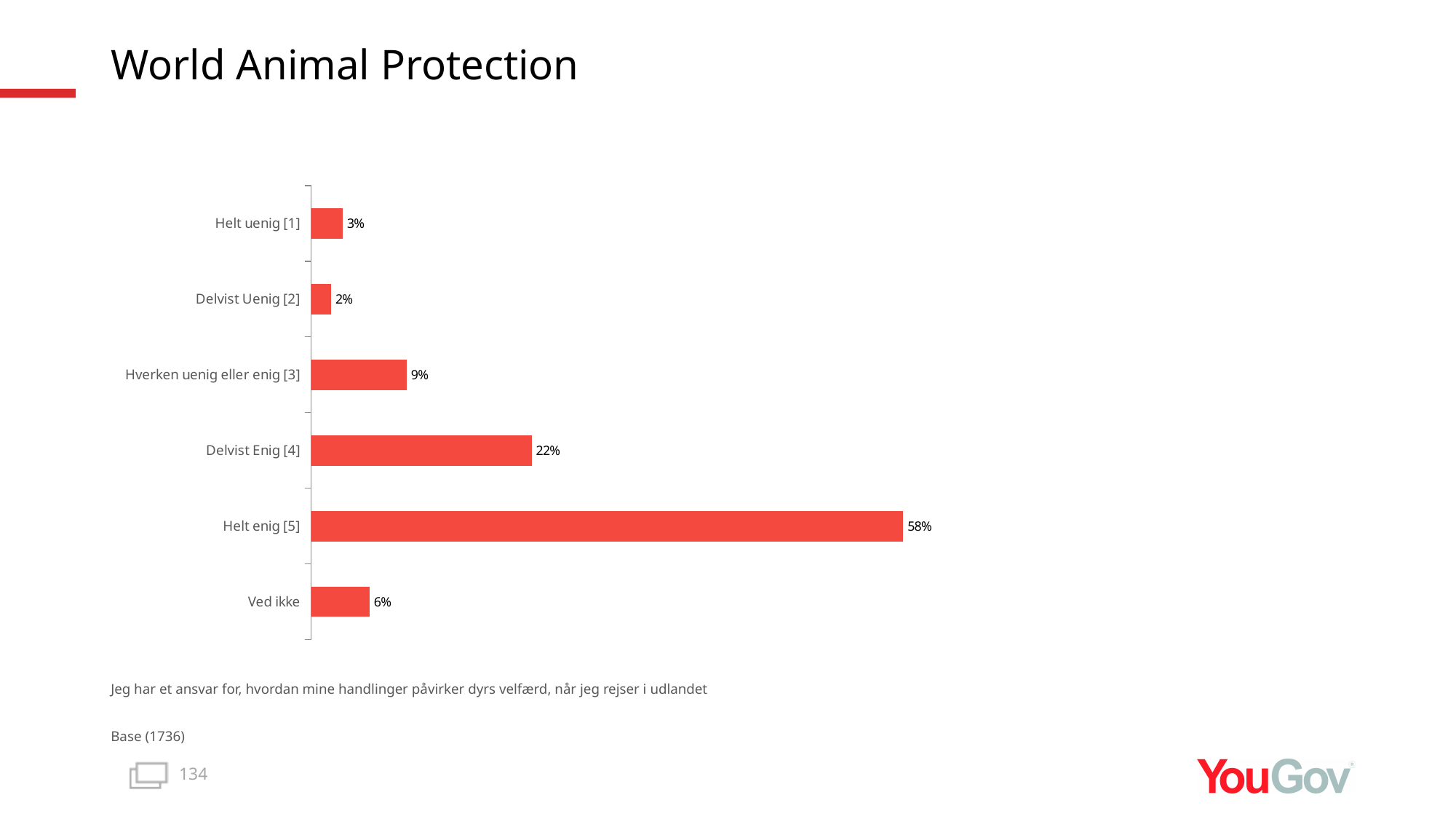
Which response category has the highest value? Helt enig [5] Which is larger, "Helt uenig [1]" or "Ved ikke"? Ved ikke Which response category has the lowest value? Delvist Uenig [2] What is the combined percentage of "Helt uenig [1]" and "Delvist Uenig [2]"? 5% What type of chart is shown on the slide? Bar chart What is the base (number of respondents) stated below the chart? 1736 How many response categories are shown in the chart? 6 What is the value shown for "Delvist Enig [4]"? 22% What percentage is shown for "Ved ikke"? 6% What is the value for "Hverken uenig eller enig [3]"? 9% What percentage of respondents answered "Helt enig [5]"? 58% What is the difference between "Helt enig [5]" and "Delvist Enig [4]"? 36%